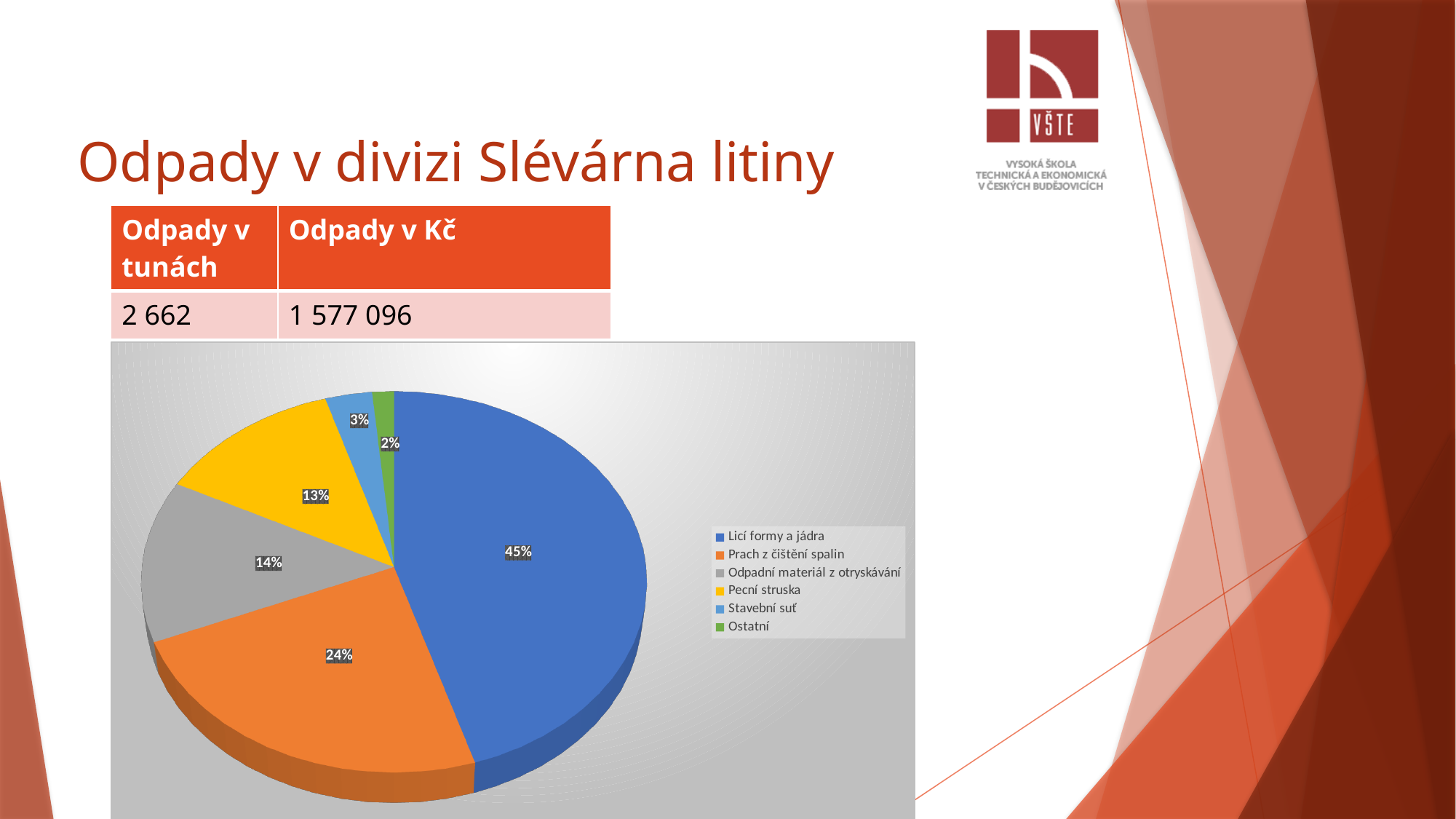
What share of the pie does Prach z čištění spalin have? 24% How many categories does the pie chart show? 6 What colour is the slice for Pecní struska? yellow Which is larger, the slice for Pecní struska or the slice for Stavební suť? Pecní struska What share of the pie does Stavební suť have? 3% What is the difference in percentage points between Licí formy a jádra and Prach z čištění spalin? 21 What kind of chart is shown on the slide? pie chart What share of the pie does Odpadní materiál z otryskávání have? 14% Which category has the largest slice of the pie? Licí formy a jádra Which category has the smallest slice of the pie? Ostatní